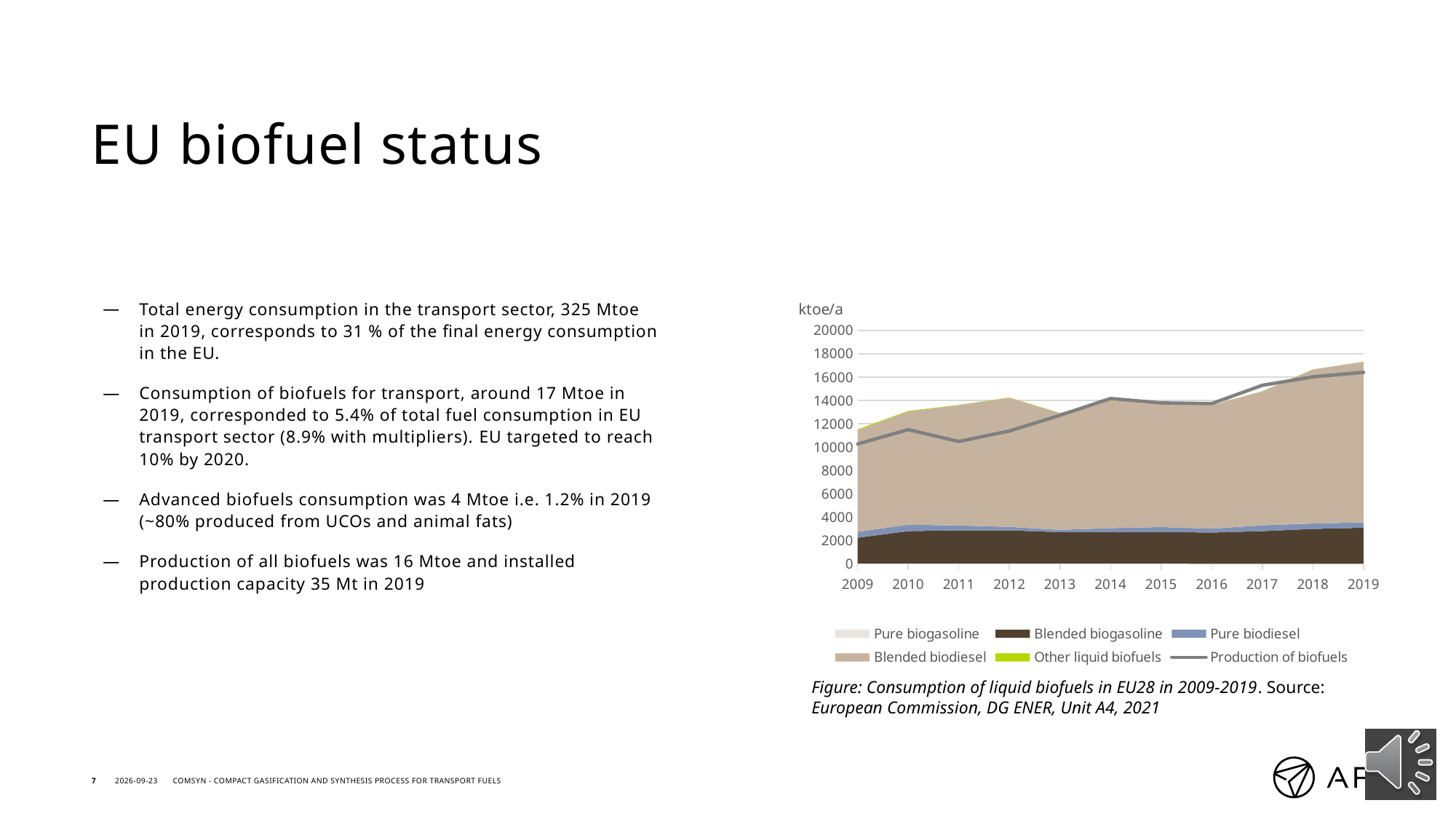
In which year is Production of biofuels highest? 2019 How many series does the chart legend list? 6 Is the value of Production of biofuels in 2011 greater or less than 10000? greater What unit is shown on the y axis of the chart? ktoe/a How many years are shown on the x axis of the chart? 11 Is the value of Production of biofuels in 2013 greater or less than 12000? greater Is the total stacked consumption of liquid biofuels in 2019 greater or less than 16000? greater Is Production of biofuels larger in 2009 or in 2019? 2019 Does Production of biofuels rise or fall from 2016 to 2019? rise Which legend entry is drawn as a grey line rather than a filled area? Production of biofuels What kind of chart is shown on the slide? Area chart (stacked area with a line)